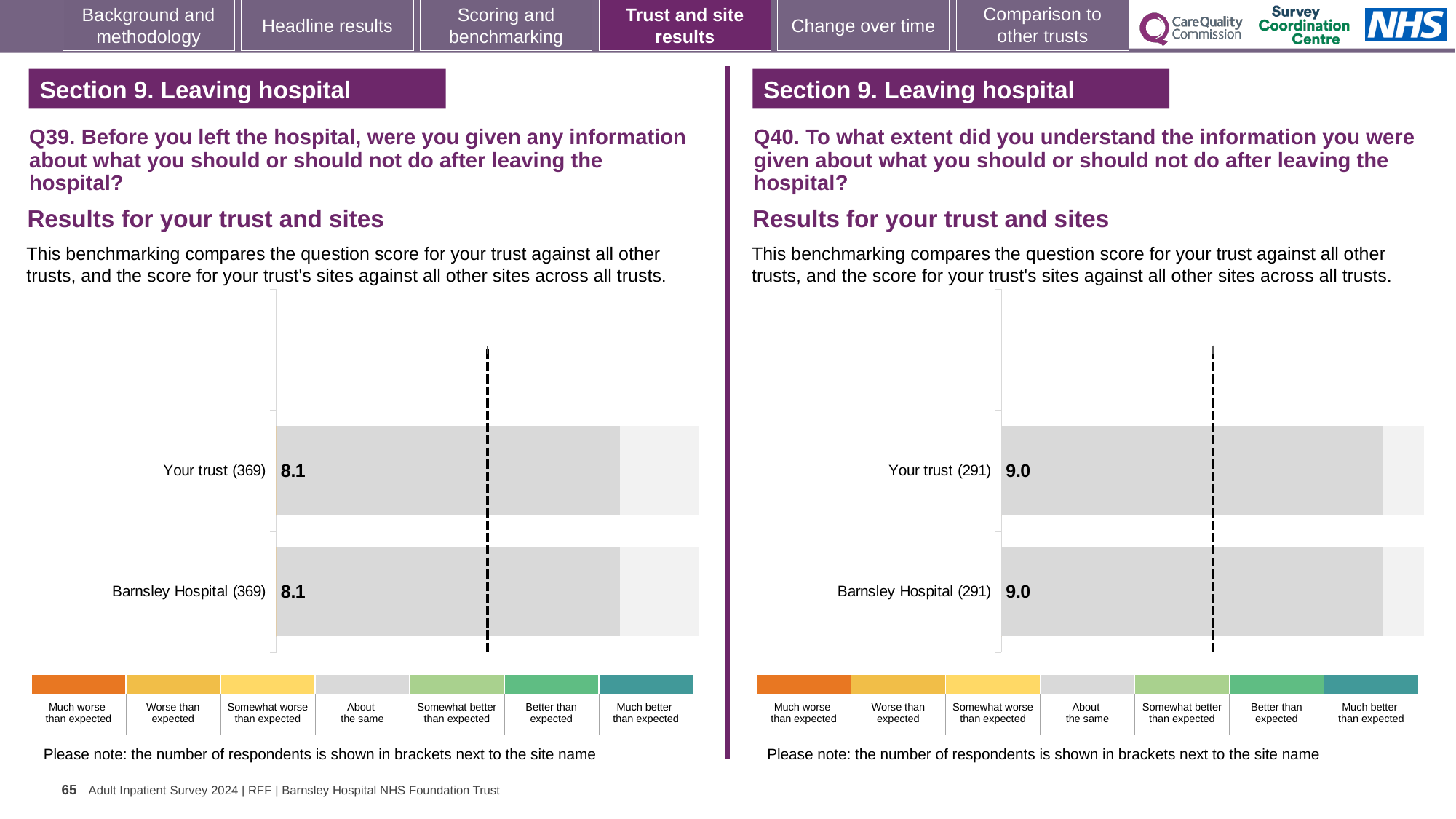
How many benchmark categories are listed in the colour key below the Q39 chart on the left? 7 In the Q40 chart on the right, what is the score for Your trust? 9.0 Is the score for Your trust in the Q40 chart on the right greater or less than the score for Your trust in the Q39 chart on the left? greater In the Q39 chart on the left, how many respondents are shown in brackets next to Barnsley Hospital? 369 In the colour key below the Q40 chart on the right, what colour represents 'Much worse than expected'? Orange How many bars are plotted in the Q40 chart on the right? 2 In the Q39 chart on the left, what is the score for Barnsley Hospital? 8.1 In the Q40 chart on the right, how many respondents are shown in brackets next to Your trust? 291 In the Q39 chart on the left, what is the difference between the score for Your trust and the score for Barnsley Hospital? 0.0 In the Q40 chart on the right, what is the score for Barnsley Hospital? 9.0 What kind of chart is used for the Q39 results on the left? Bar chart In the Q39 chart on the left, what is the score for Your trust? 8.1